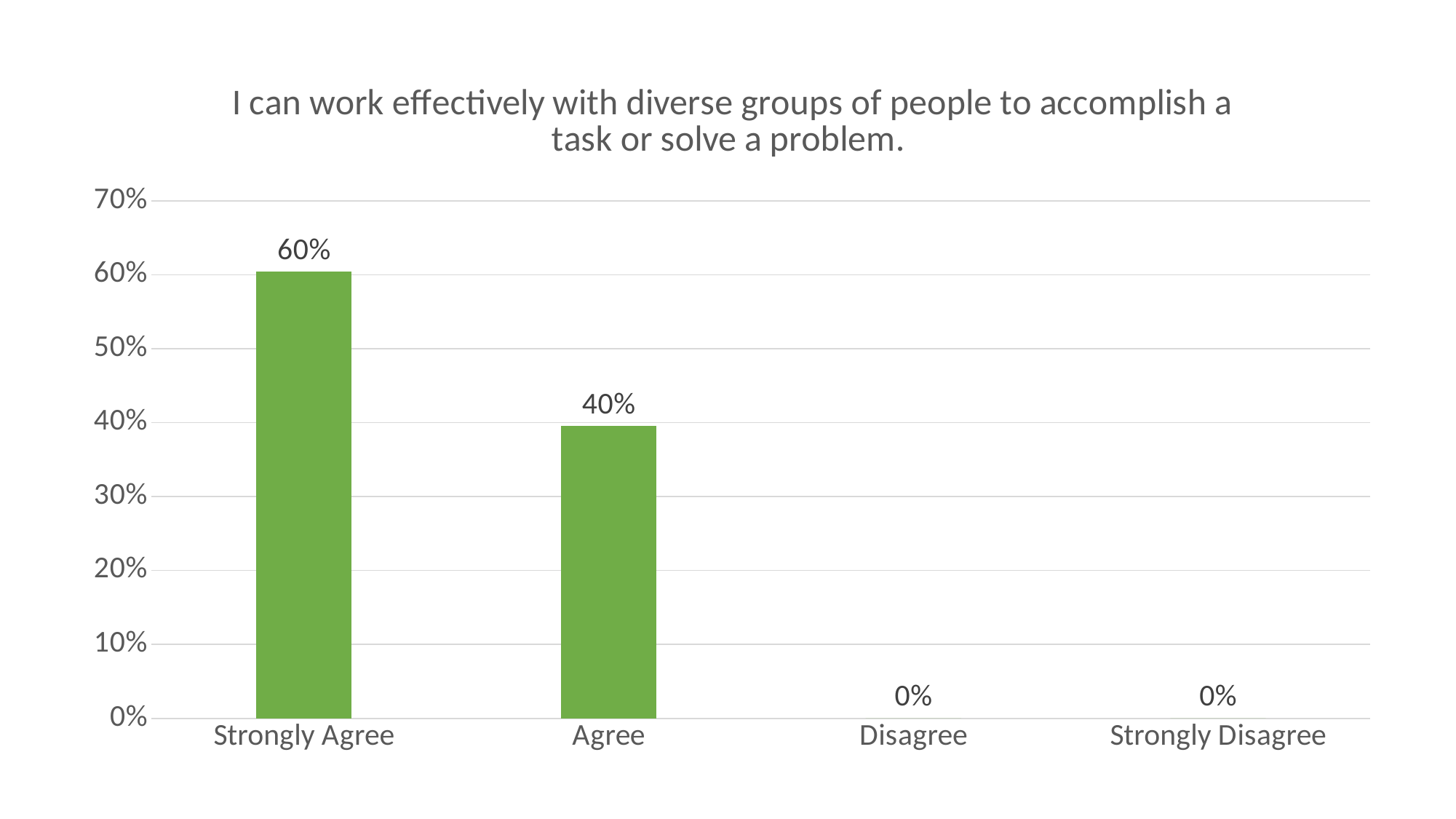
What is the title of the chart? I can work effectively with diverse groups of people to accomplish a task or solve a problem. What is the value for Strongly Agree? 60% Which category has the highest value? Strongly Agree Is the value for Strongly Agree greater or less than 50%? greater What is the value for Agree? 40% What is the value for Strongly Disagree? 0% What kind of chart is shown on the slide? bar chart How many categories are shown on the x axis? 4 What is the difference between the values for Strongly Agree and Agree? 20% Which is larger, the value for Agree or the value for Disagree? Agree Do the values rise or fall from Strongly Agree to Strongly Disagree? fall What is the value for Disagree? 0%